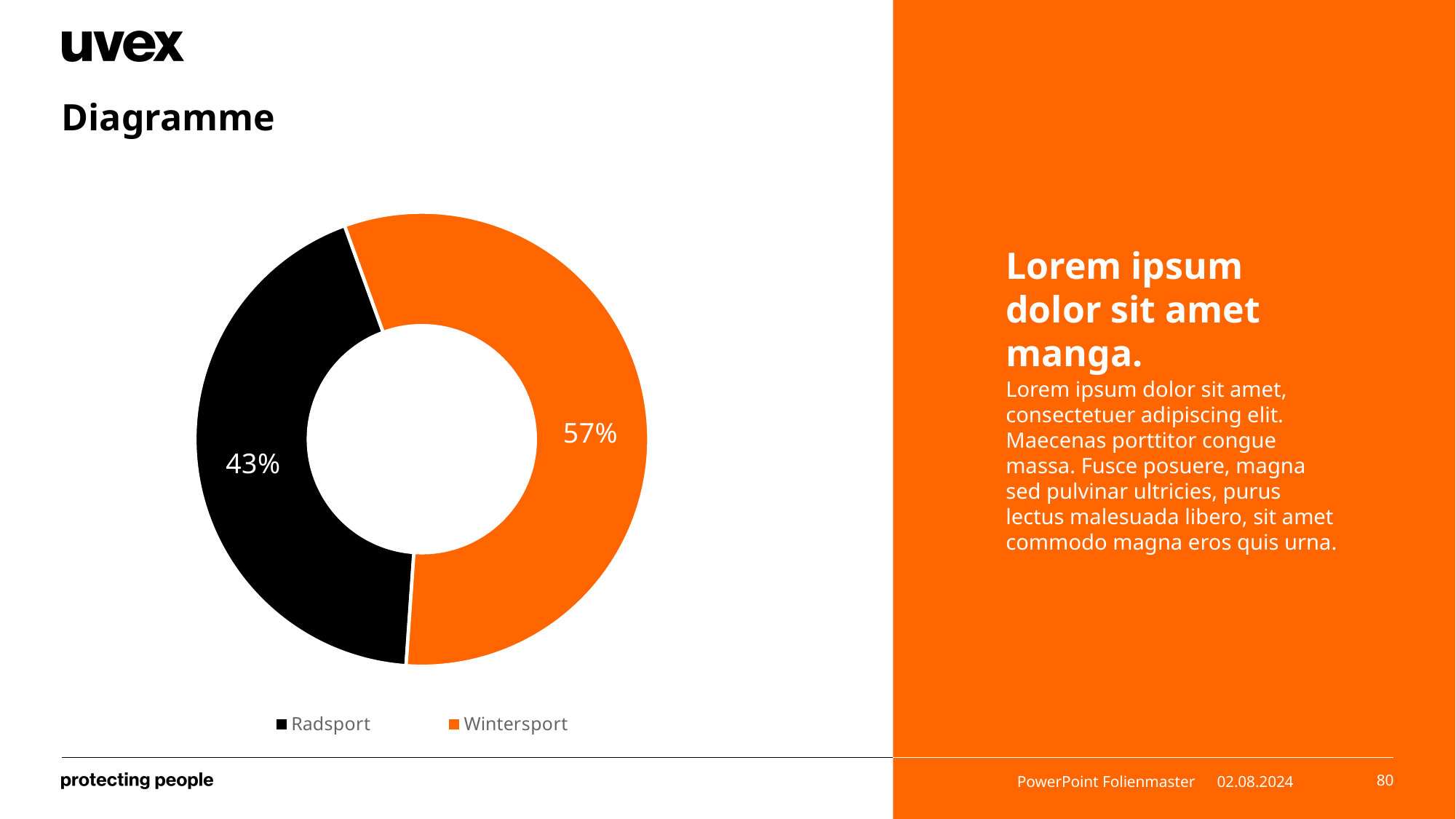
How many categories does the chart show? 2 What is the difference in percentage points between the Wintersport and Radsport shares? 14 Which is larger, the share for Radsport or the share for Wintersport? Wintersport Is the share for Wintersport greater or less than 50%? greater What colour is the Radsport segment in the chart? Black What share of the doughnut chart does Radsport account for? 43% Which category has the smallest share in the chart? Radsport What colour is the Wintersport segment in the chart? Orange What kind of chart is shown on the slide? Doughnut chart What share of the doughnut chart does Wintersport account for? 57% Which category has the largest share in the chart? Wintersport